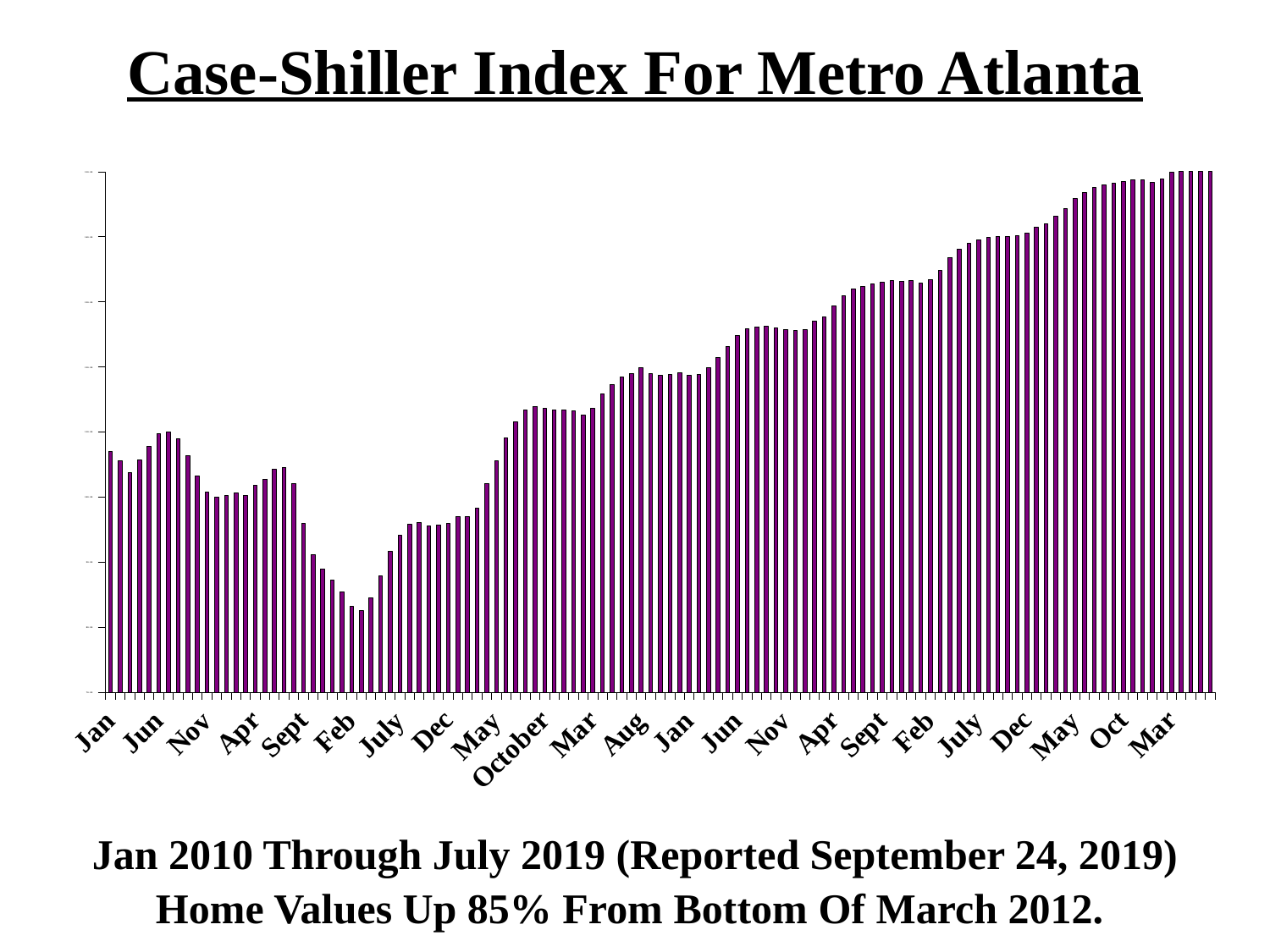
Near which x-axis label is the lowest bar of the chart located? Feb Between the 'Sept' label and the 'Feb' label on the left part of the chart, do the values rise or fall? fall Where along the x axis are the highest bars of the chart located? at the far right Which is larger: the first bar on the left (Jan) or the last bar on the right? the last bar on the right What is the title of the chart? Case-Shiller Index For Metro Atlanta How many data series are plotted in the chart? 1 Which is larger: the bar at the first 'Jan' label or the lowest bar near the 'Feb' label? the bar at the first 'Jan' label What colour are the bars in the chart? purple What kind of chart is shown on the slide? bar chart Overall, do the values rise or fall from the left of the x axis to the right? rise